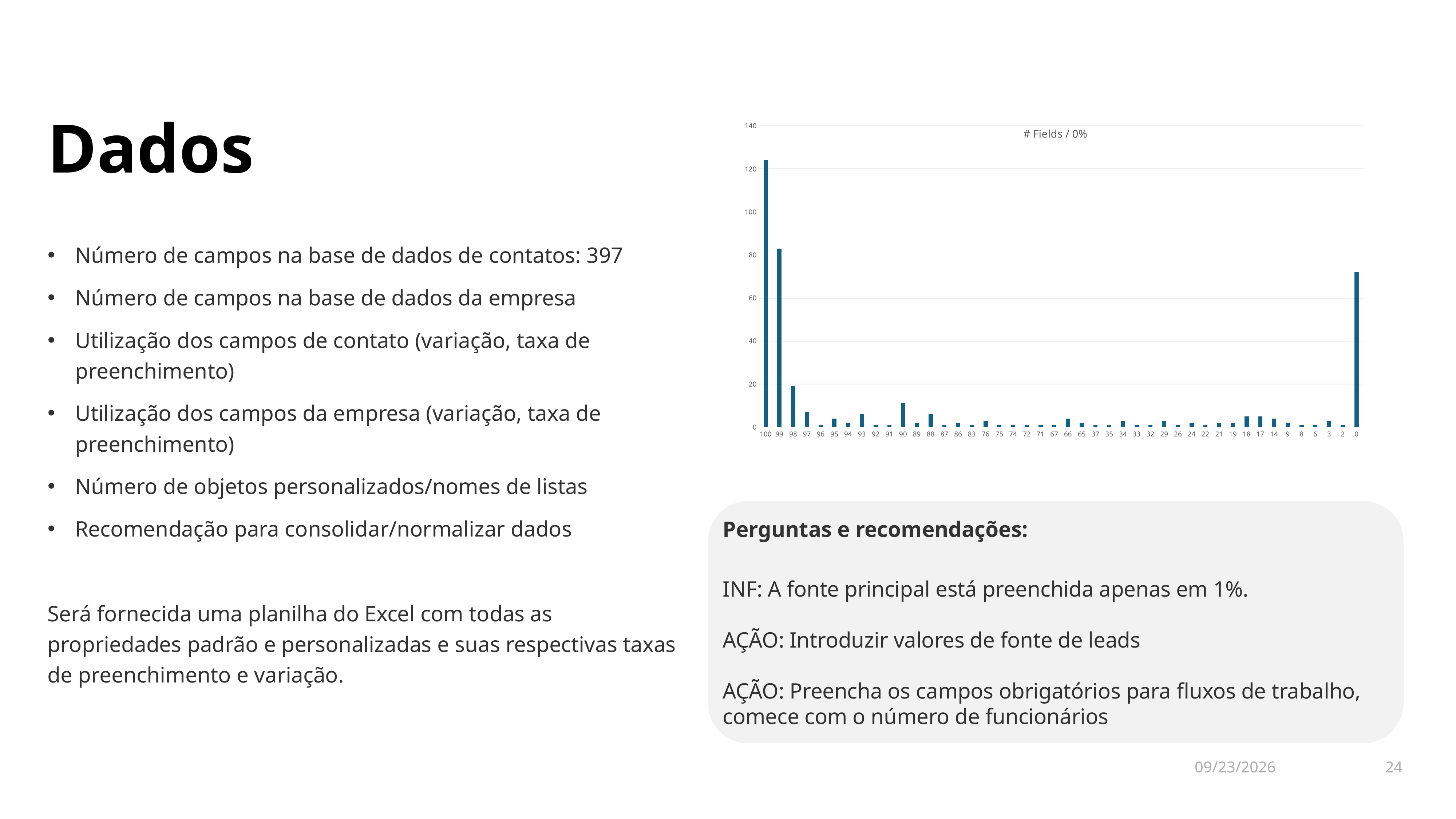
Is the value for category 100 greater or less than 120? greater What kind of chart is shown on the slide? bar chart Is the value for category 0 greater or less than 60? greater What is the title of the chart? # Fields / 0% Is the value for category 0 greater or less than 80? less How many categories are shown on the x axis of the chart? 44 Which has the larger value, category 0 or category 98? 0 Which has the larger value, category 99 or category 0? 99 What is the highest tick value shown on the y axis of the chart? 140 Which category has the highest bar in the chart? 100